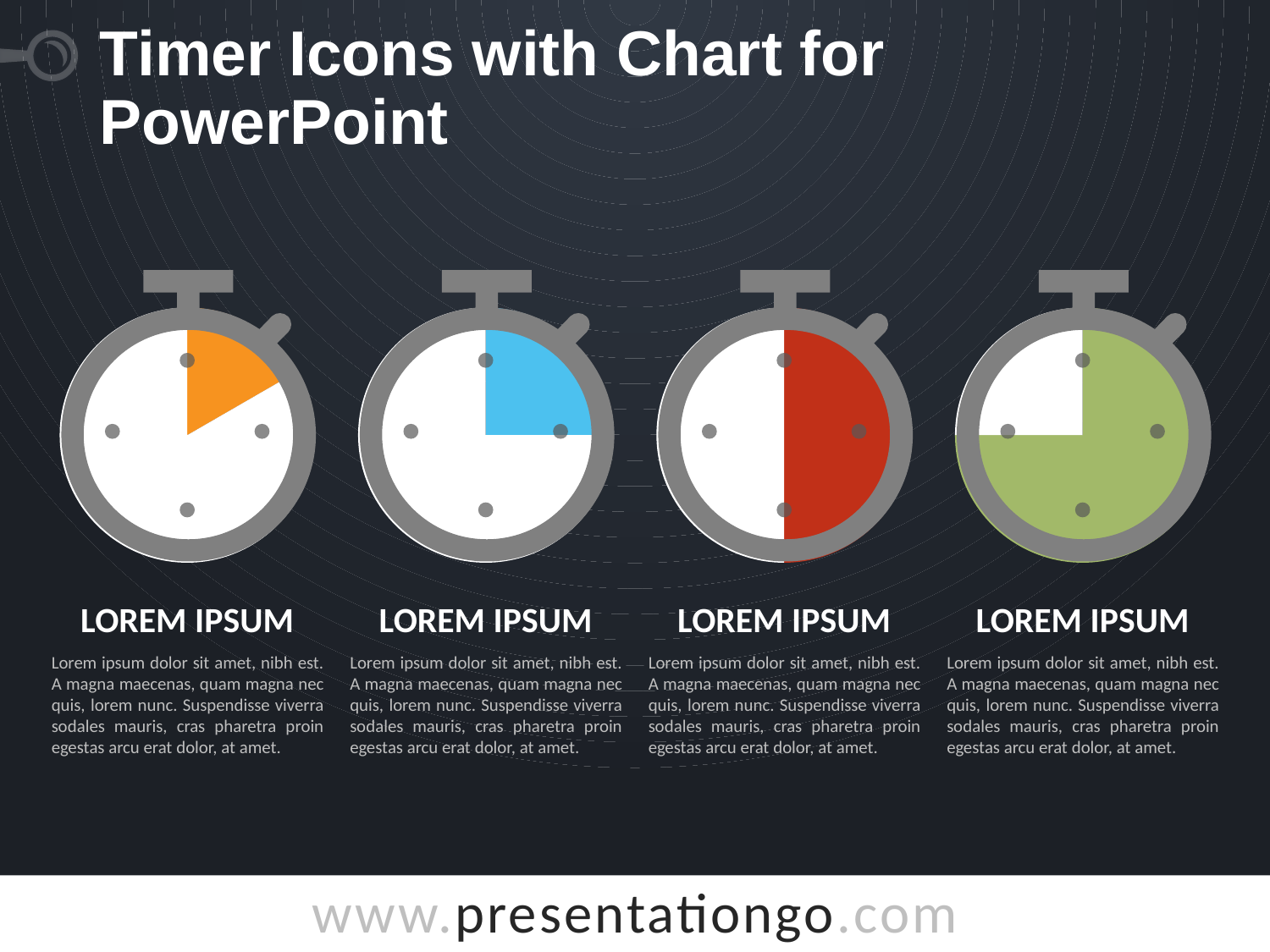
What colour is the filled portion of the third timer icon? Red Which timer icon has the largest filled portion? The fourth (green) timer Is the filled portion of the orange timer larger or smaller than that of the green timer? smaller Which timer icon has the smallest filled portion? The first (orange) timer What colour is the filled portion of the second timer icon? Blue Do the filled portions of the timers increase or decrease from left to right? increase How many timer icons are shown on the slide? 4 Is the filled portion of the red timer larger or smaller than that of the blue timer? larger